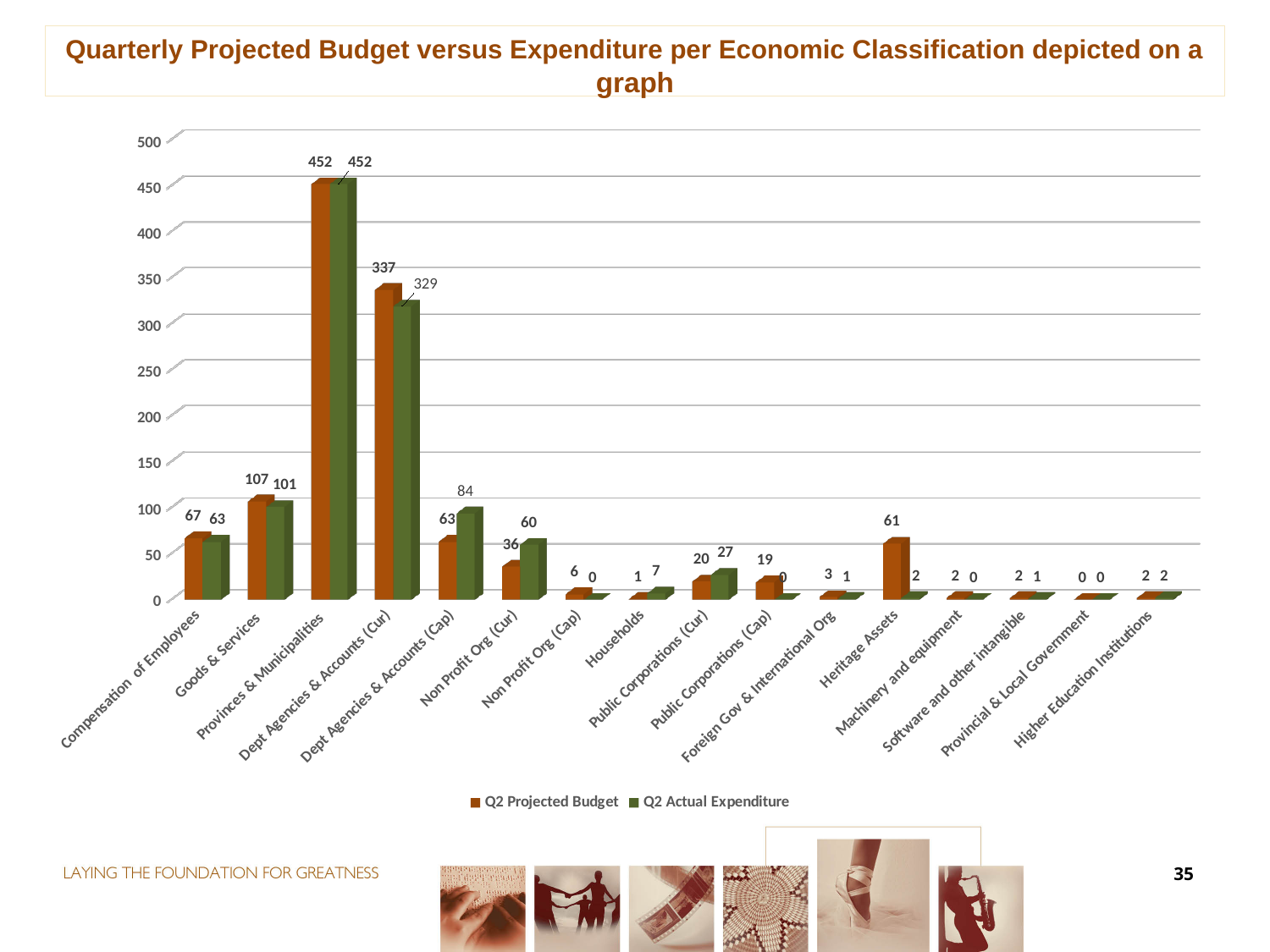
What is the Q2 Actual Expenditure for Dept Agencies & Accounts (Cap)? 84 What type of chart is shown on the slide? Bar chart Which category has the highest Q2 Actual Expenditure? Provinces & Municipalities What is the Q2 Projected Budget for Heritage Assets? 61 What is the Q2 Projected Budget for Provinces & Municipalities? 452 What is the difference between the Q2 Projected Budget and Q2 Actual Expenditure for Goods & Services? 6 For Non Profit Org (Cur), which is larger: the Q2 Projected Budget or the Q2 Actual Expenditure? Q2 Actual Expenditure How many series does the chart's legend list? 2 Is the Q2 Projected Budget for Dept Agencies & Accounts (Cur) greater or less than 300? greater What is the Q2 Actual Expenditure for Dept Agencies & Accounts (Cur)? 329 What is the difference between the Q2 Projected Budget and Q2 Actual Expenditure for Dept Agencies & Accounts (Cur)? 8 How many categories are shown on the x axis of the chart? 16